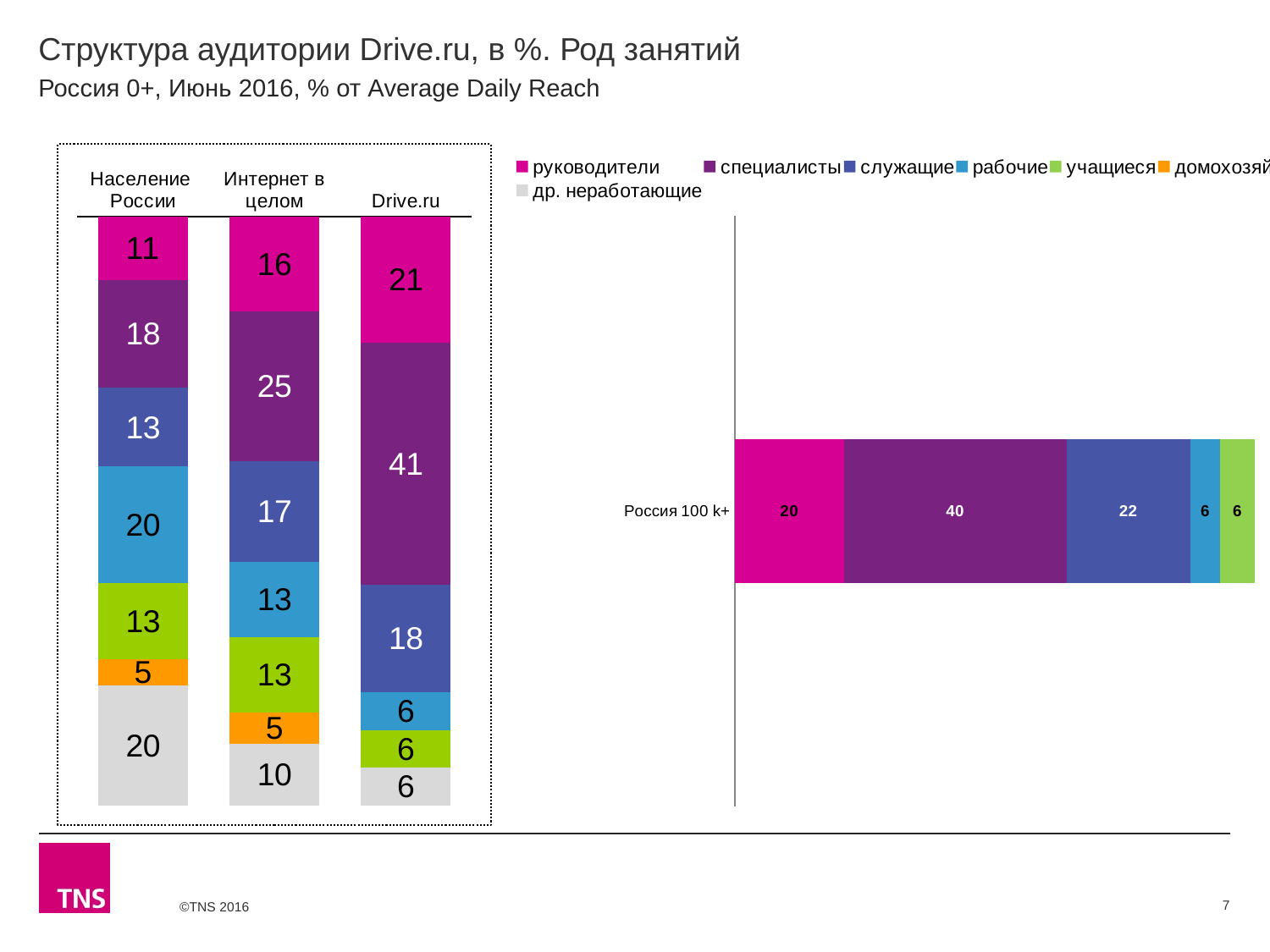
How many bars (categories) does the left stacked bar chart show? 3 In the right chart, what is the value of the специалисты segment for Россия 100 k+? 40 In the left stacked bar chart, what is the difference between the специалисты values for Drive.ru and Интернет в целом? 16 In the left stacked bar chart, what is the value of the руководители segment for Население России? 11 In the right chart, what is the total of the Россия 100 k+ stacked bar? 94 In the left stacked bar chart, what is the value of the служащие segment for Интернет в целом? 17 What type of chart is shown on the right side of the slide? Stacked bar chart In the left stacked bar chart, is the рабочие value larger for Население России or for Drive.ru? Население России In the left stacked bar chart, which bar has the smallest руководители segment? Население России Which legend entry is shown in pink? руководители In the left stacked bar chart, which of the three bars has the largest специалисты segment? Drive.ru In the left stacked bar chart, what is the value of the специалисты segment for Drive.ru? 41